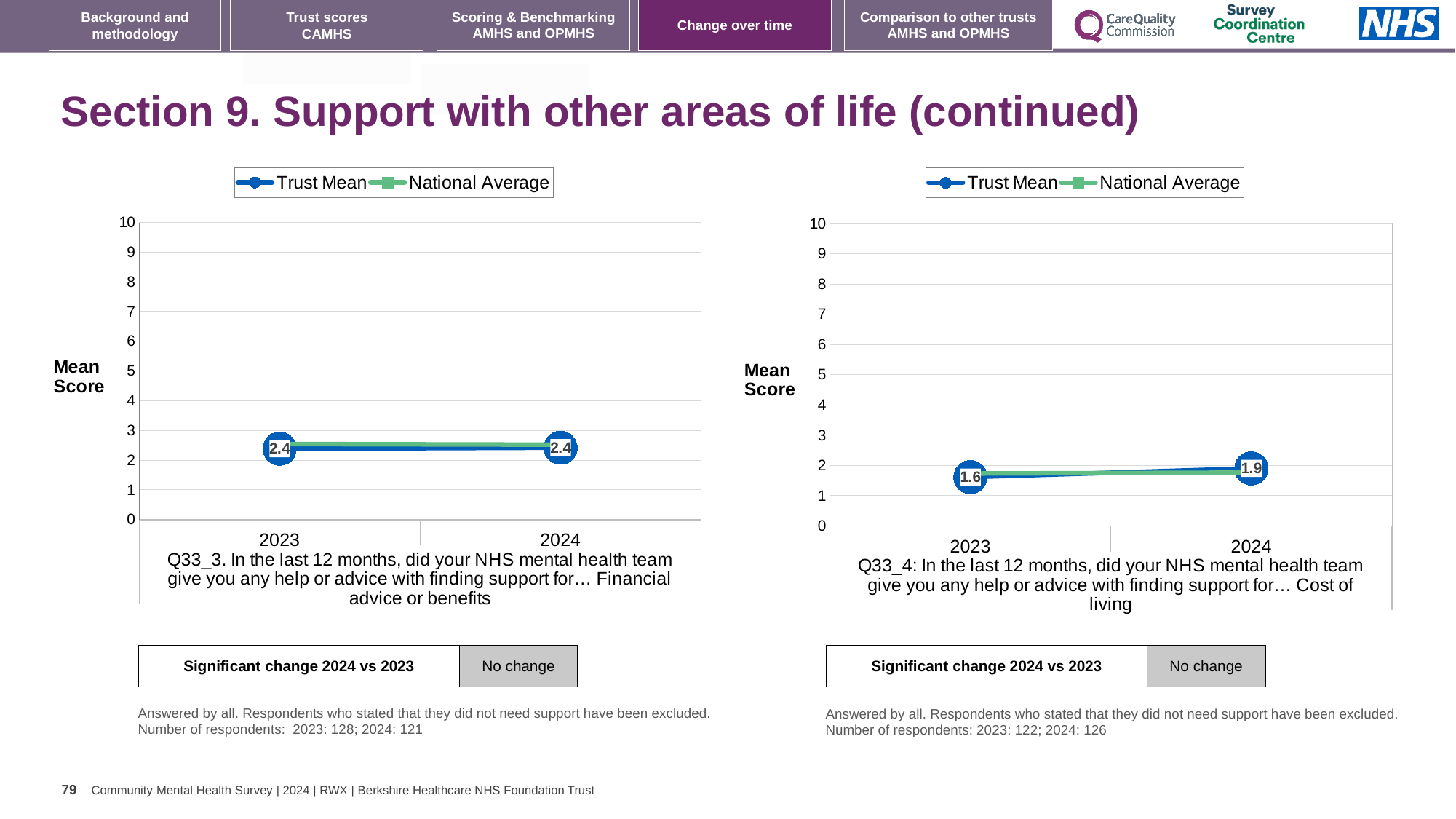
How many years are plotted on the x axis of the right chart? 2 On the right chart (Q33_4, Cost of living), what is the Trust Mean for 2024? 1.9 On the right chart (Q33_4, Cost of living), is the Trust Mean for 2023 greater or less than 2? less How many series does the legend of the left chart list? 2 On the right chart (Q33_4, Cost of living), what is the difference between the Trust Mean for 2024 and 2023? 0.3 On the right chart (Q33_4, Cost of living), what is the Trust Mean for 2023? 1.6 On the left chart (Q33_3, Financial advice or benefits), what is the Trust Mean for 2024? 2.4 On the left chart (Q33_3, Financial advice or benefits), is the Trust Mean for 2024 greater or less than 3? less What type of chart is the left chart (Q33_3)? line chart On the right chart (Q33_4, Cost of living), does the Trust Mean rise or fall from 2023 to 2024? rise On the left chart (Q33_3, Financial advice or benefits), what is the Trust Mean for 2023? 2.4 On the right chart (Q33_4, Cost of living), which year has the higher Trust Mean? 2024